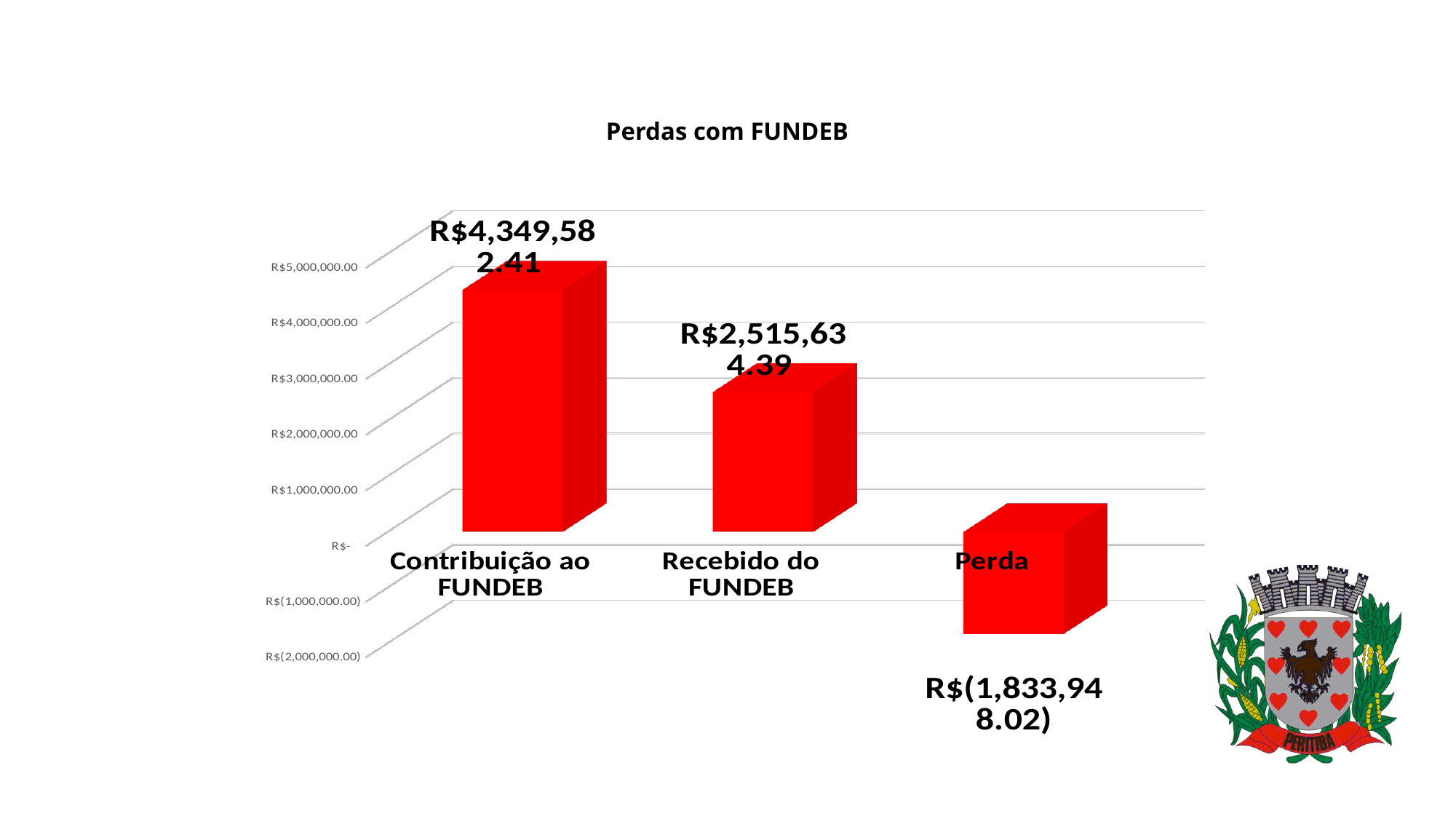
Which is larger, Contribuição ao FUNDEB or Recebido do FUNDEB? Contribuição ao FUNDEB Is the value for Contribuição ao FUNDEB greater or less than R$4,000,000.00? greater What is the title of the chart? Perdas com FUNDEB What kind of chart is shown on the slide? bar chart What is the value for Contribuição ao FUNDEB? R$4,349,582.41 What is the difference between Contribuição ao FUNDEB and Recebido do FUNDEB? R$1,833,948.02 Which category has the lowest value? Perda What is the value for Recebido do FUNDEB? R$2,515,634.39 Is the value for Recebido do FUNDEB greater or less than R$3,000,000.00? less What is the value shown for Perda? R$(1,833,948.02) How many categories are shown in the chart? 3 Which category has the highest value? Contribuição ao FUNDEB